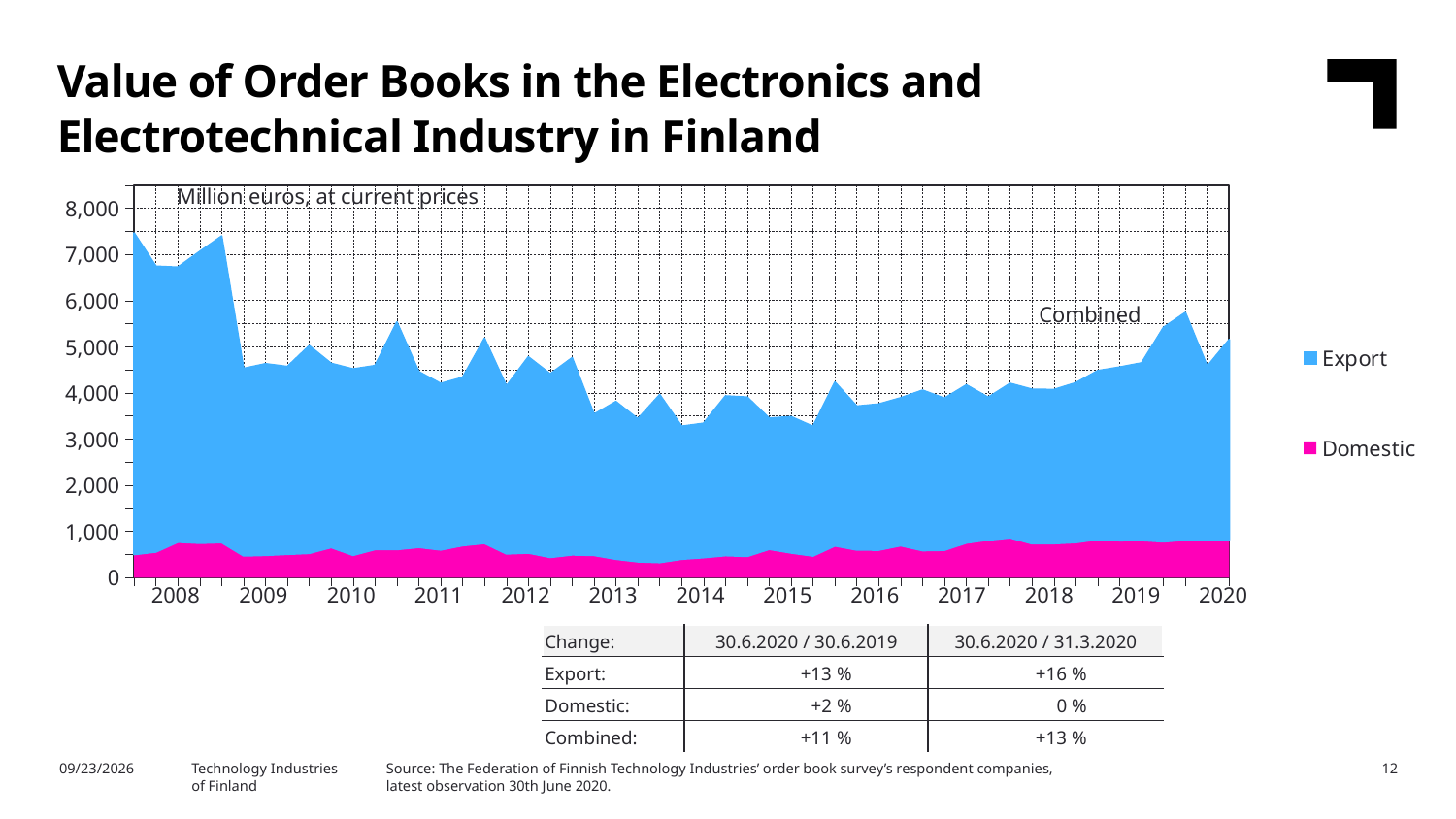
Is the combined value at 2020 greater or less than 4,000? greater Which series is larger throughout the period, Export or Domestic? Export Is the Domestic value at the start of 2018 greater or less than 1,000? less What kind of chart is shown on the slide? Area chart Does the combined value rise or fall from 2008 to 2014? Fall In which year does the combined value reach its highest level? 2008 Is the combined value at the start of 2014 greater or less than 4,000? less What are the two series named in the legend? Export and Domestic How many year labels are shown on the x axis? 13 How many series does the legend list? 2 What unit is stated at the top of the chart? Million euros, at current prices